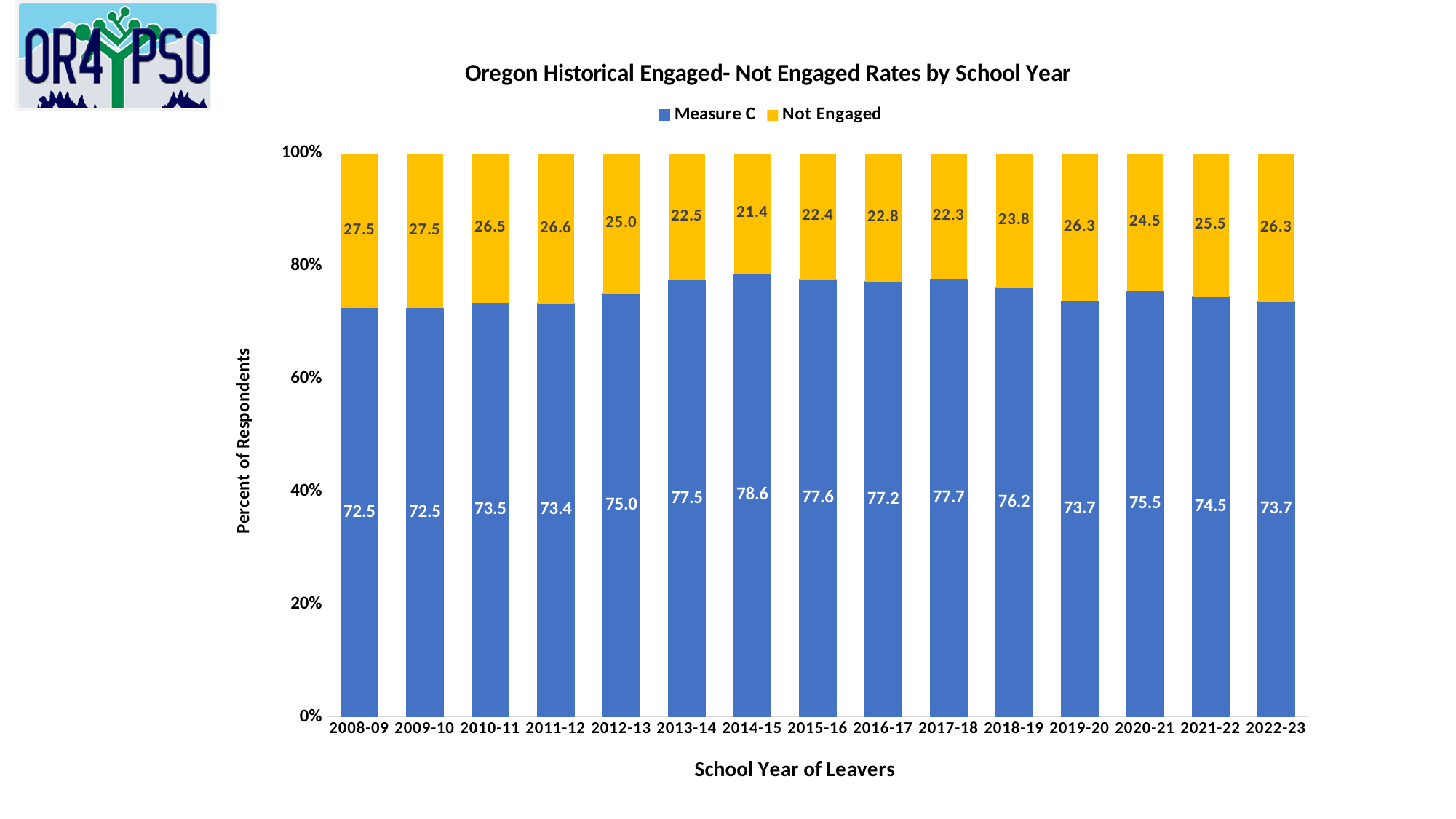
How many series does the legend list? 2 How many school years are shown on the x axis? 15 What is the Measure C value for 2014-15? 78.6 What is the title of the chart? Oregon Historical Engaged- Not Engaged Rates by School Year What is the label on the y axis? Percent of Respondents What is the difference between the Measure C values for 2014-15 and 2008-09? 6.1 What kind of chart is shown on the slide? Stacked bar chart Which is larger, the Not Engaged value for 2019-20 or for 2020-21? 2019-20 What is the Not Engaged value for 2018-19? 23.8 Which school year has the lowest Not Engaged value? 2014-15 Which school year has the highest Measure C value? 2014-15 What is the total of the stacked bar for 2012-13? 100.0